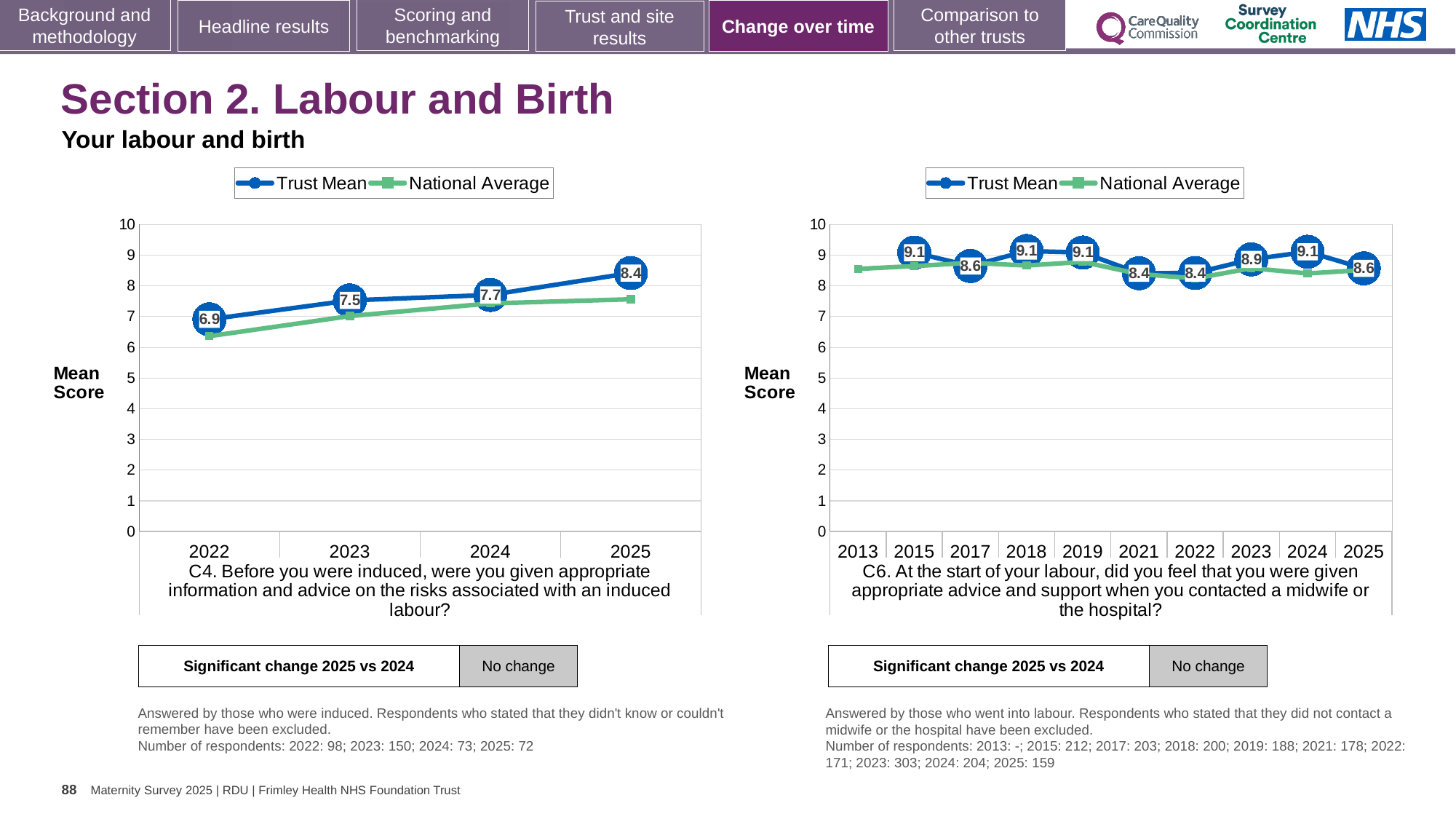
In the left chart (C4), is the National Average for 2022 greater or less than 7? less In the left chart (C4), what is the Trust Mean for 2022? 6.9 How many series does the legend of the right chart (C6) list? 2 In the right chart (C6), how many years are shown on the x axis? 10 In the left chart (C4), what is the difference between the Trust Mean for 2025 and 2022? 1.5 In the right chart (C6), what is the Trust Mean for 2025? 8.6 In the right chart (C6), what is the Trust Mean for 2021? 8.4 In the right chart (C6), which is larger, the Trust Mean for 2023 or for 2025? 2023 In the left chart (C4), does the Trust Mean rise or fall from 2022 to 2025? rise In the left chart (C4), which year has the highest Trust Mean? 2025 In the left chart (C4), what is the Trust Mean for 2025? 8.4 In the left chart (C4), which year has the lowest Trust Mean? 2022